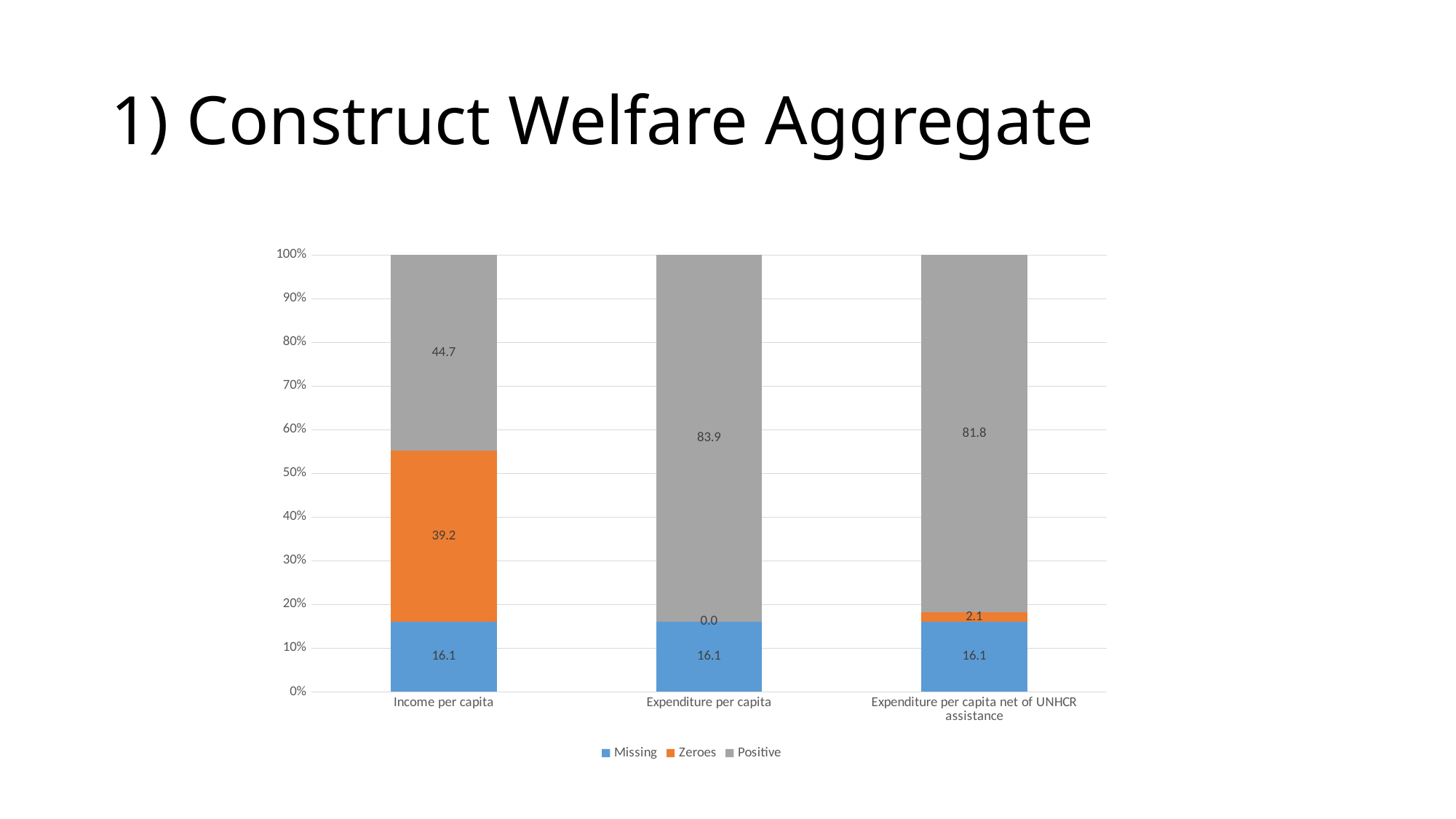
How many categories are shown on the x axis? 3 Which category has the lowest Zeroes value? Expenditure per capita Which category has the highest Positive value? Expenditure per capita What is the value of the Zeroes series for Income per capita? 39.2 What is the value of the Missing series for Expenditure per capita net of UNHCR assistance? 16.1 What is the value of the Zeroes series for Expenditure per capita net of UNHCR assistance? 2.1 Which colour represents the Zeroes series in the legend? Orange How many series does the legend list? 3 What is the value of the Positive series for Expenditure per capita? 83.9 What kind of chart is shown on the slide? Stacked bar chart Is the Zeroes value larger for Income per capita or for Expenditure per capita net of UNHCR assistance? Income per capita What is the difference between the Positive values for Expenditure per capita and Income per capita? 39.2